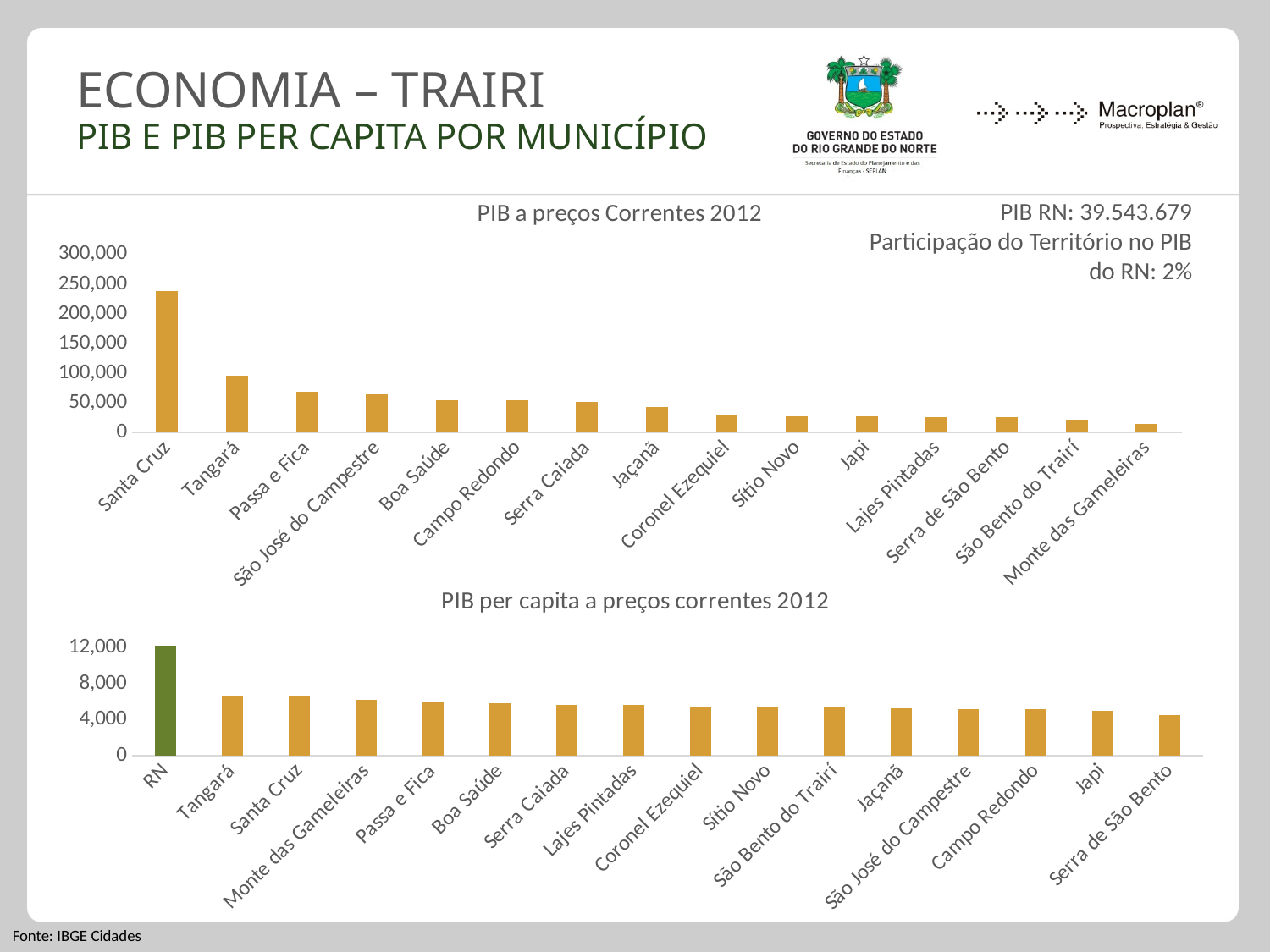
In the top chart 'PIB a preços Correntes 2012', which municipality has the highest value? Santa Cruz How many bars are shown in the bottom chart 'PIB per capita a preços correntes 2012'? 16 In the top chart 'PIB a preços Correntes 2012', is the value for Santa Cruz greater or less than 200,000? greater How many municipalities are shown in the top chart 'PIB a preços Correntes 2012'? 15 In the bottom chart 'PIB per capita a preços correntes 2012', which bar is the highest? RN In the top chart 'PIB a preços Correntes 2012', is the value for Monte das Gameleiras greater or less than 50,000? less In the top chart 'PIB a preços Correntes 2012', do the values rise or fall from left to right? Fall What kind of chart is the top chart, 'PIB a preços Correntes 2012'? Bar chart In the bottom chart 'PIB per capita a preços correntes 2012', is the value for Tangará greater or less than 8,000? less In the top chart 'PIB a preços Correntes 2012', which municipality has the lowest value? Monte das Gameleiras In the bottom chart 'PIB per capita a preços correntes 2012', which category has the lowest value? Serra de São Bento